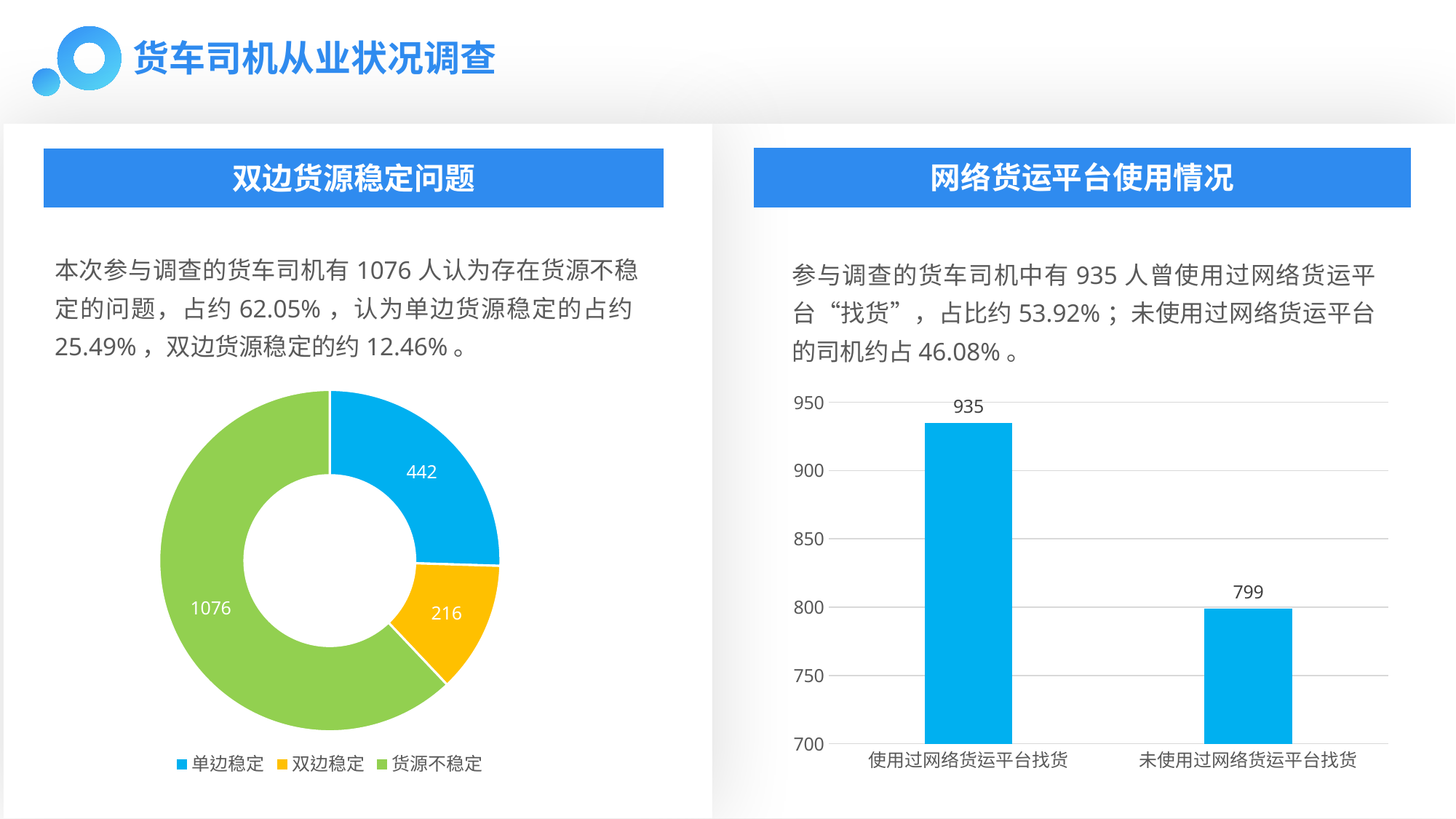
In the right chart (网络货运平台使用情况), which is larger: 使用过网络货运平台找货 or 未使用过网络货运平台找货? 使用过网络货运平台找货 In the right chart (网络货运平台使用情况), what is the difference between the two bars? 136 What kind of chart is shown on the right under 网络货运平台使用情况? Bar chart In the right chart (网络货运平台使用情况), what is the value for 未使用过网络货运平台找货? 799 In the left chart (双边货源稳定问题), what is the difference between the values for 单边稳定 and 双边稳定? 226 In the left chart (双边货源稳定问题), what is the value for 货源不稳定? 1076 In the left chart (双边货源稳定问题), what share of the total does 货源不稳定 represent? 62.05% In the left chart (双边货源稳定问题), what is the value for 双边稳定? 216 What kind of chart is shown on the left under 双边货源稳定问题? Pie (donut) chart In the left chart (双边货源稳定问题), which category has the smallest value? 双边稳定 In the left chart (双边货源稳定问题), how many categories does the legend list? 3 In the left chart (双边货源稳定问题), which category has the largest value? 货源不稳定